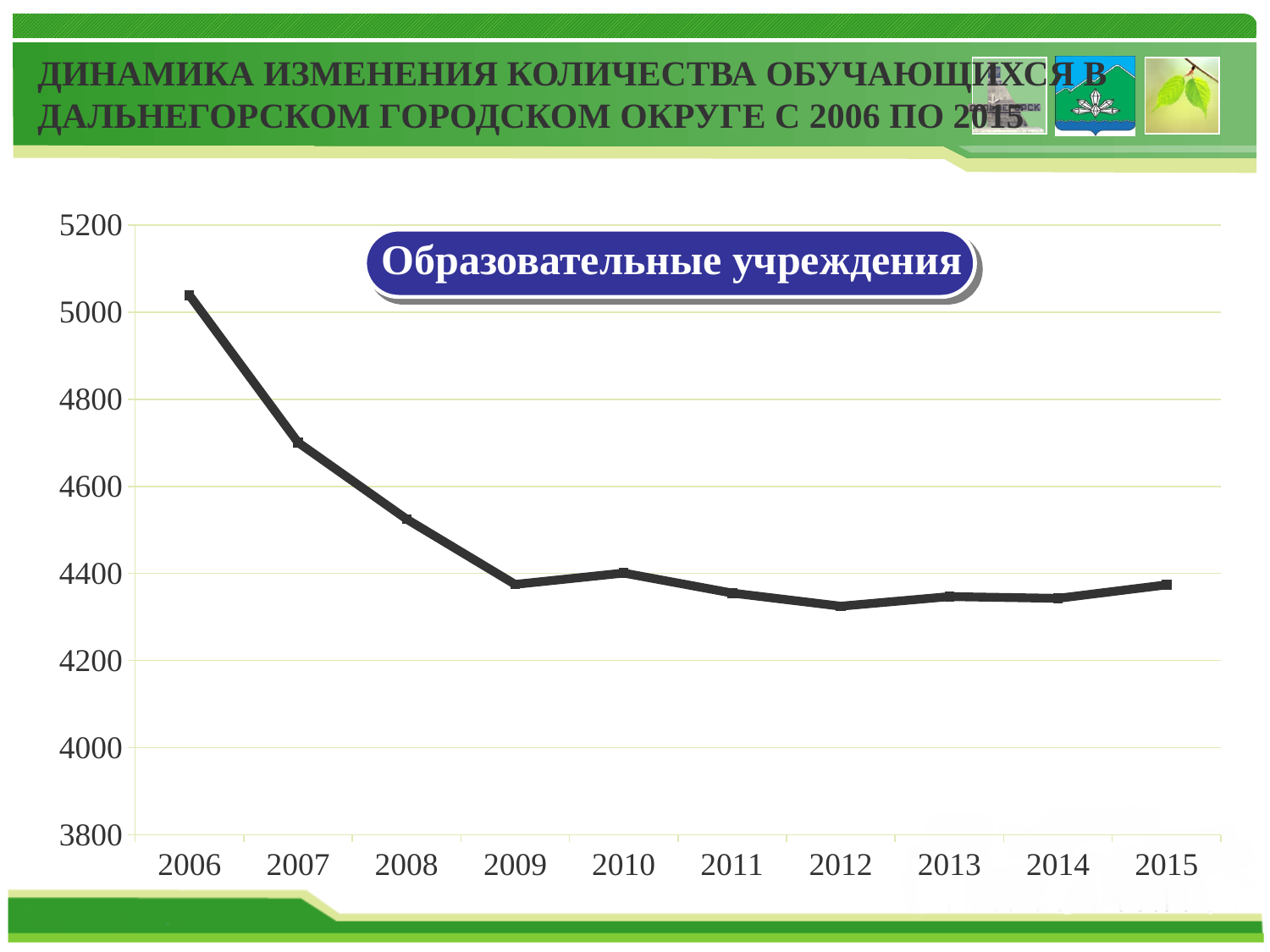
What label is shown in the box above the chart line? Образовательные учреждения Is the value for 2008 greater or less than 4600? less Is the value for 2012 greater or less than 4400? less Which year has the highest value on the chart? 2006 Which is larger, the value for 2006 or the value for 2015? 2006 Which is larger, the value for 2007 or the value for 2008? 2007 Is the value for 2007 greater or less than 4800? less What kind of chart is shown on the slide? line chart How many years are plotted along the x axis? 10 Do the values generally rise or fall from 2006 to 2015? fall